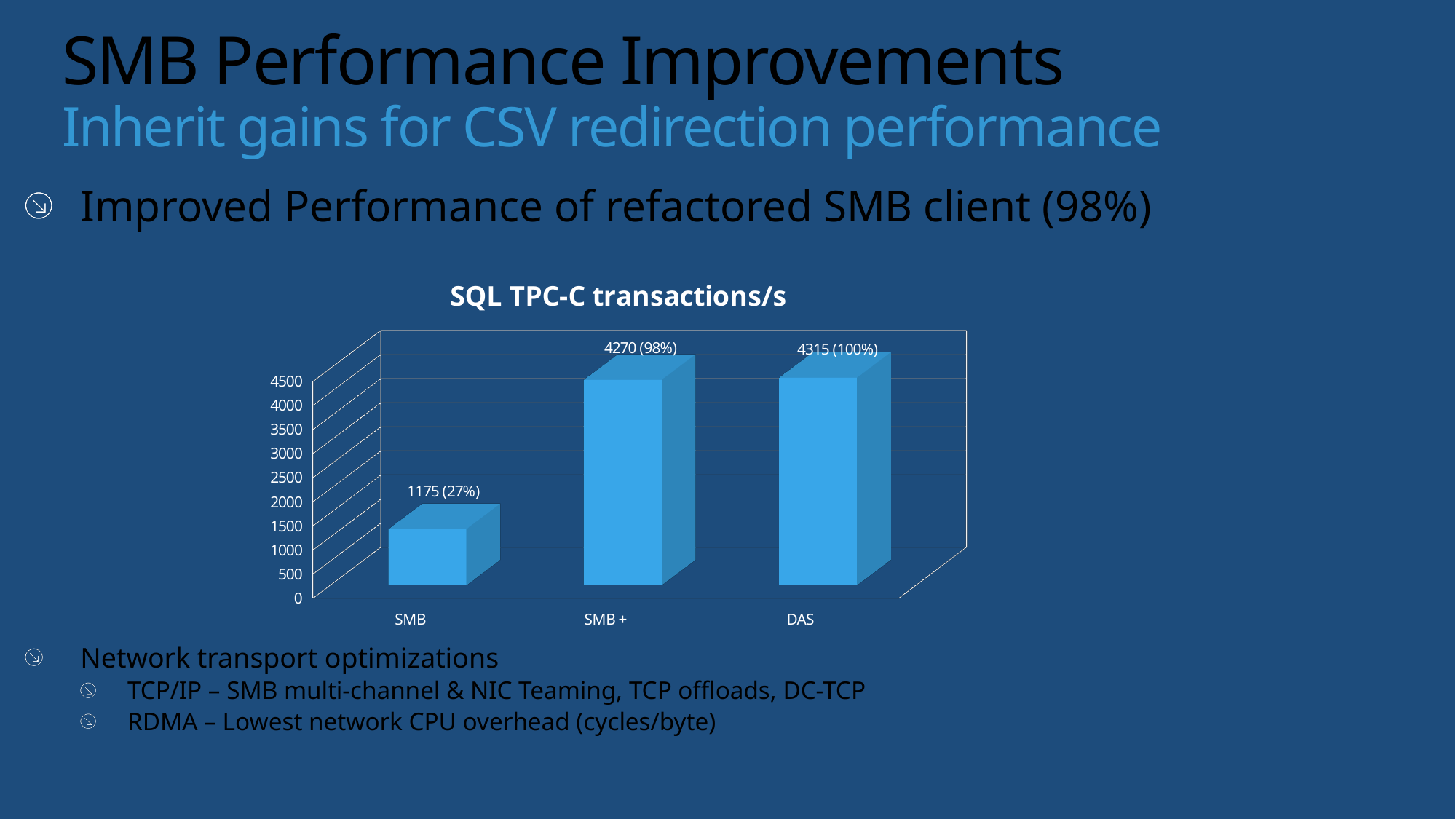
How many categories are shown in the SQL TPC-C transactions/s chart? 3 What is the value for SMB in the SQL TPC-C transactions/s chart? 1175 (27%) Which is larger, the value for SMB or the value for SMB +? SMB + What is the value for DAS in the SQL TPC-C transactions/s chart? 4315 (100%) What is the value for SMB + in the SQL TPC-C transactions/s chart? 4270 (98%) What is the difference in transactions/s between DAS and SMB +? 45 Which category has the highest value in the SQL TPC-C transactions/s chart? DAS Which category has the lowest value in the SQL TPC-C transactions/s chart? SMB What kind of chart is shown on the slide? bar chart What is the difference in transactions/s between SMB + and SMB? 3095 What is the title of the chart on the slide? SQL TPC-C transactions/s Is the value for SMB greater or less than 1500? less